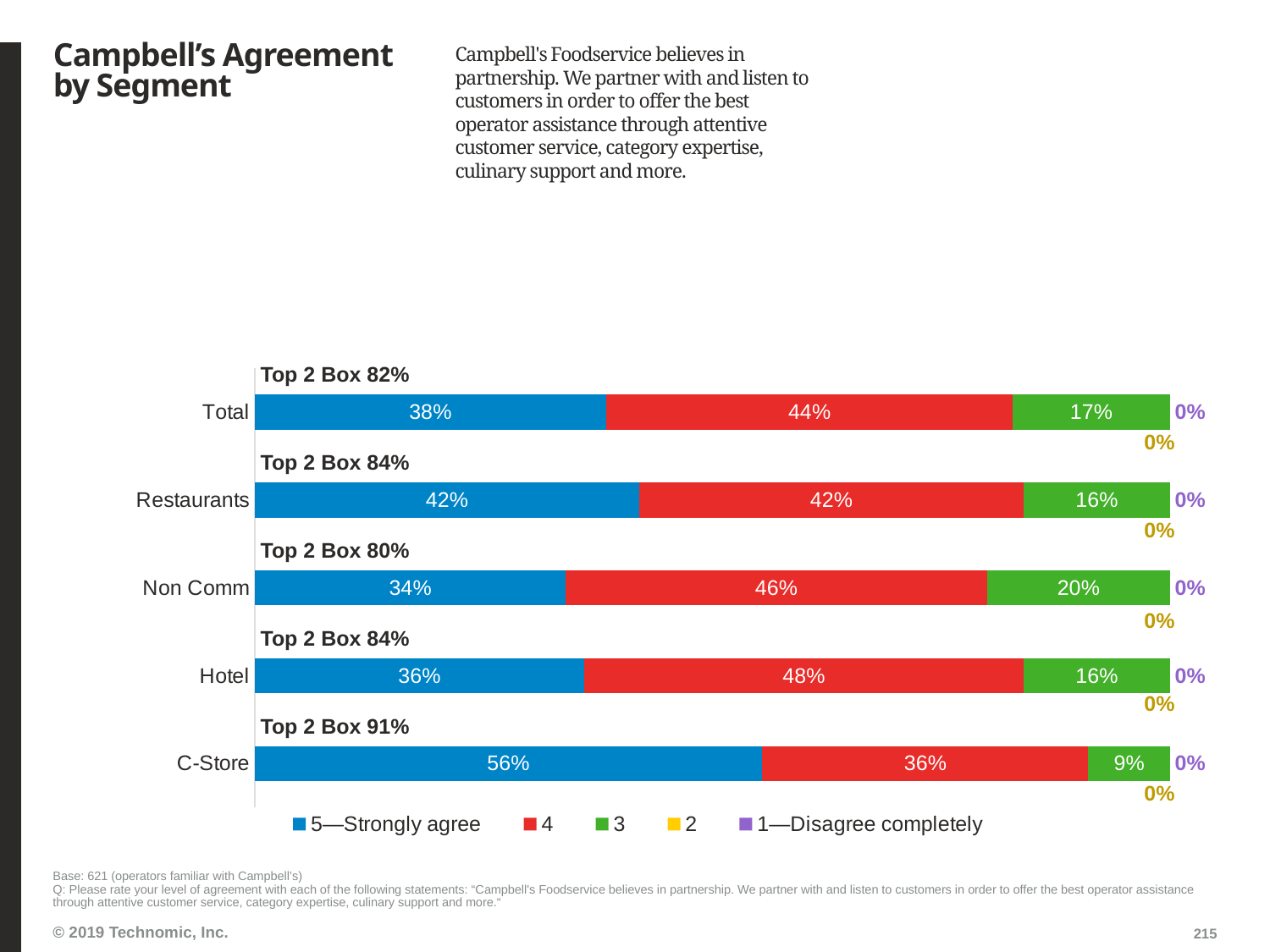
What percentage of Non Comm operators gave a rating of 4? 46% What is the Top 2 Box value for Hotel? 84% How many segments are shown on the chart? 5 Which segment has the highest '5—Strongly agree' percentage? C-Store What percentage of C-Store operators answered '5—Strongly agree'? 56% What is the Top 2 Box value for Total? 82% How many series does the legend list? 5 Which is larger: the rating-4 percentage for Hotel or for Restaurants? Hotel What kind of chart is shown on the slide? Stacked bar chart Which colour represents '5—Strongly agree' in the legend? Blue Which segment has the lowest percentage for rating 3? C-Store What is the difference between the '5—Strongly agree' percentages for C-Store and Non Comm? 22 percentage points